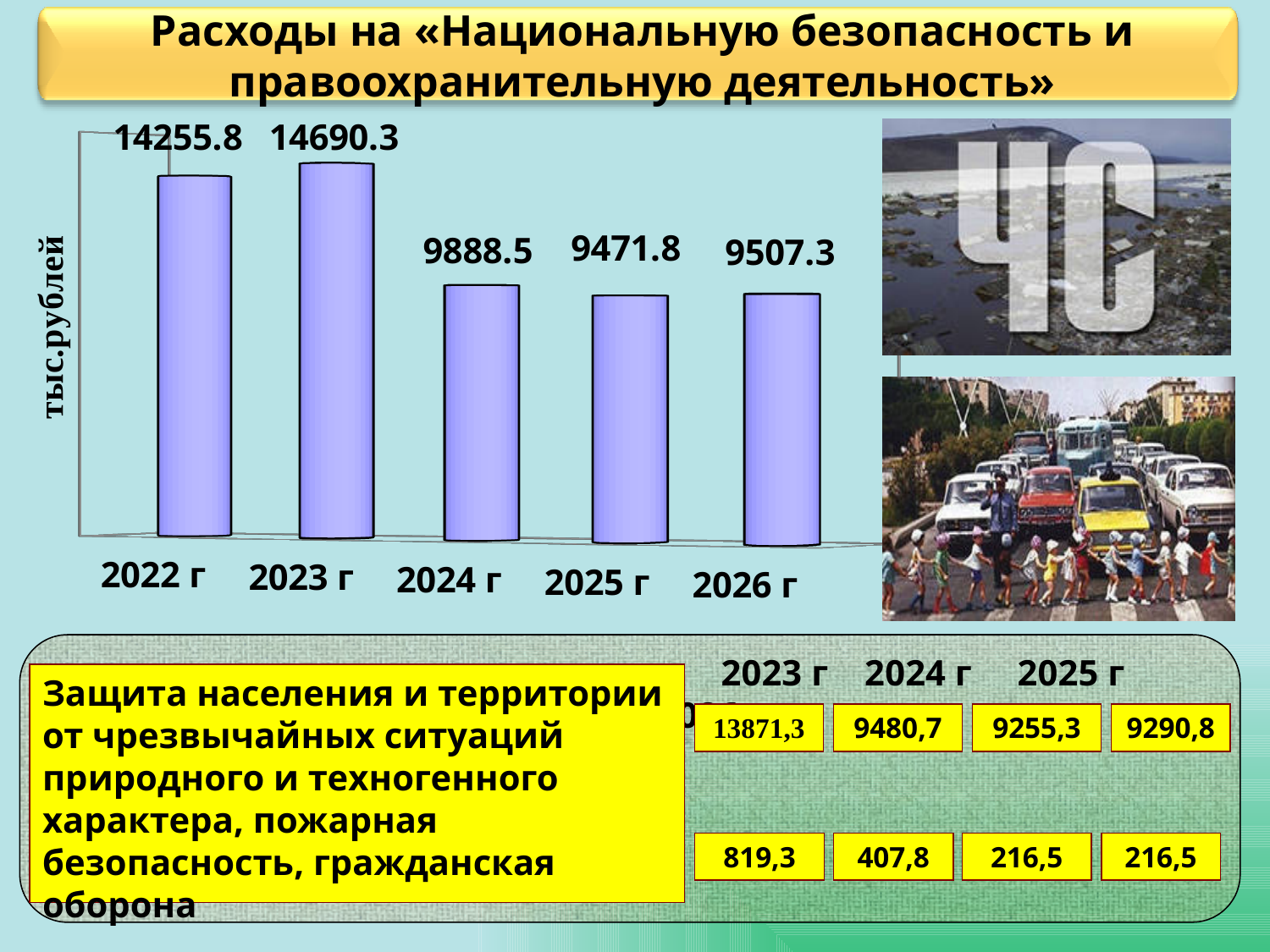
What is the value for 2024 г in the bar chart? 9888.5 What is the difference between the values for 2023 г and 2022 г? 434.5 Which year has the lowest value in the bar chart? 2025 г How many years are shown in the bar chart? 5 Do the values generally rise or fall from 2023 г to 2025 г? fall What type of chart is shown on the slide? bar chart What is the value for 2022 г in the bar chart? 14255.8 What unit is shown on the vertical axis label of the bar chart? тыс.рублей What is the difference between the values for 2024 г and 2025 г? 416.7 What is the value for 2026 г in the bar chart? 9507.3 Which is larger, the value for 2022 г or the value for 2023 г? 2023 г Which year has the highest value in the bar chart? 2023 г